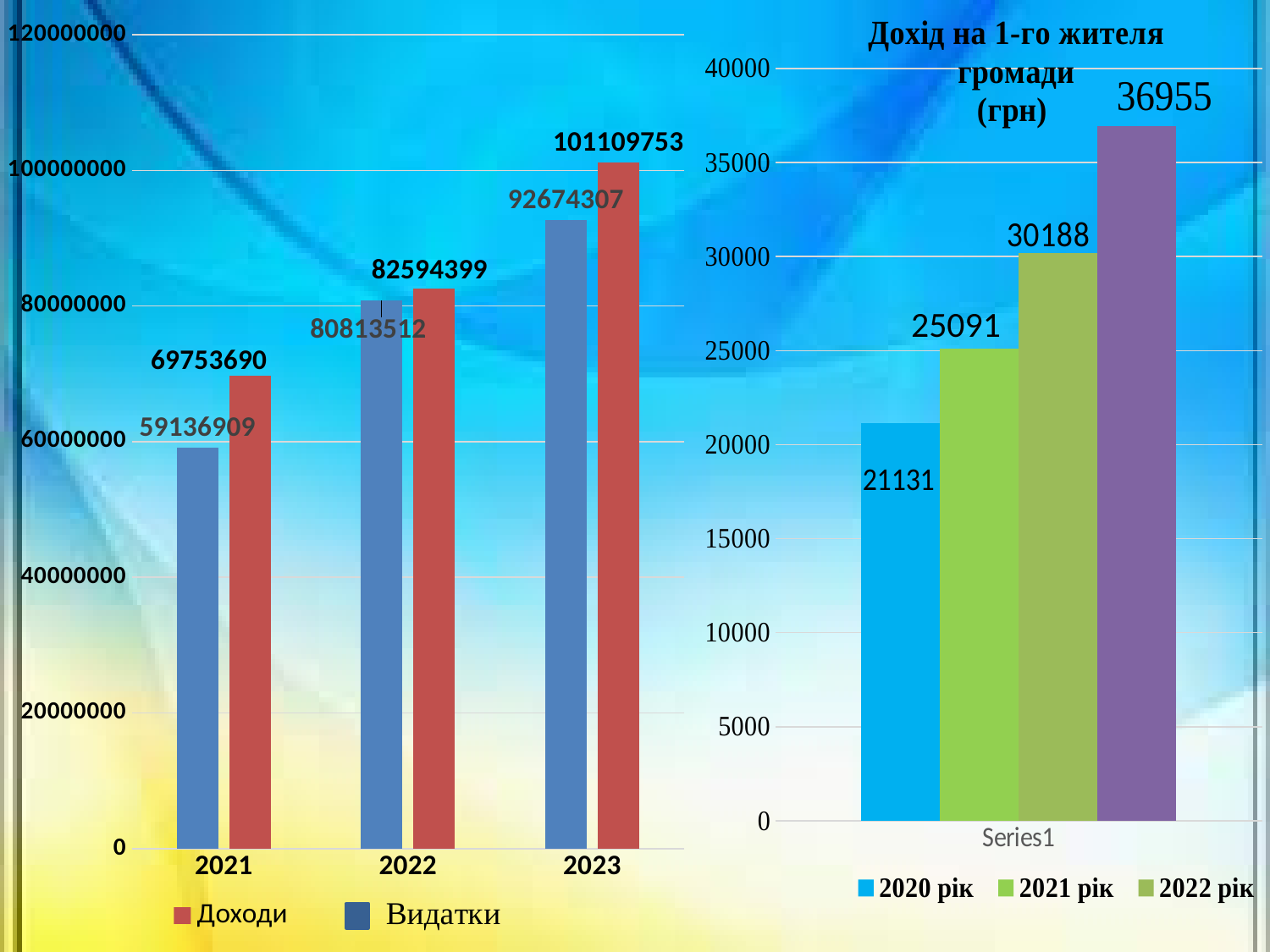
On the left chart, which year has the highest Доходи value? 2023 On the left chart, what is the difference between Доходи and Видатки in 2021? 10616781 On the chart titled 'Дохід на 1-го жителя громади (грн)', what is the value for 2020 рік? 21131 On the chart titled 'Дохід на 1-го жителя громади (грн)', what is the value for 2022 рік? 30188 On the left chart, what is the value of Видатки for 2022? 80813512 On the left chart, what is the value of Видатки for 2021? 59136909 On the chart titled 'Дохід на 1-го жителя громади (грн)', what is the highest value shown? 36955 On the left chart, do the Видатки values rise or fall from 2021 to 2023? rise On the left chart, which is larger in 2022, Доходи or Видатки? Доходи What kind of chart is the chart titled 'Дохід на 1-го жителя громади (грн)'? bar chart On the left chart, what is the value of Доходи for 2023? 101109753 On the left chart, how many series does the legend list? 2